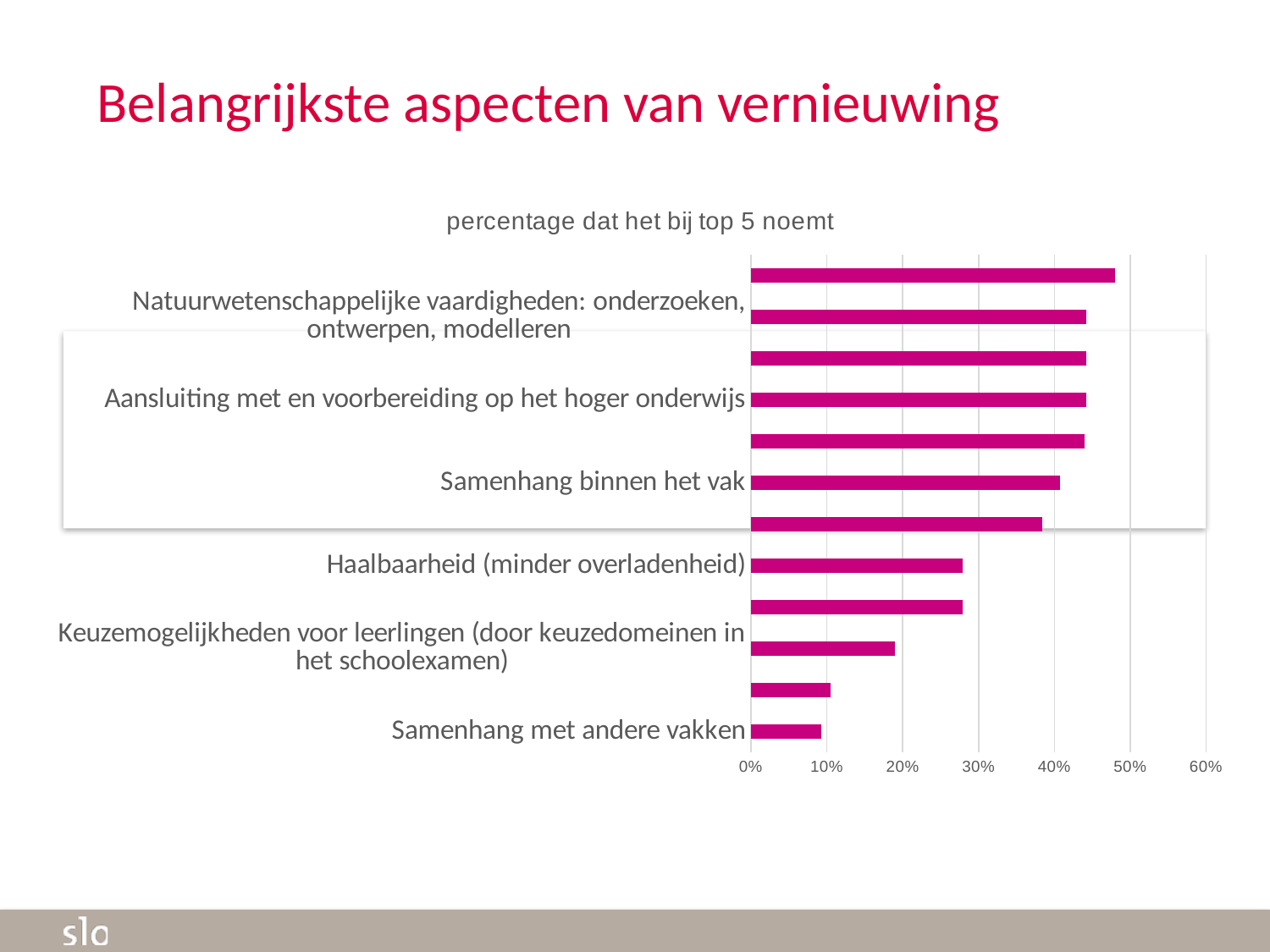
Is the value for 'Natuurwetenschappelijke vaardigheden: onderzoeken, ontwerpen, modelleren' greater or less than 50%? less Is the value for 'Samenhang binnen het vak' greater or less than 30%? greater What kind of chart is shown on the slide? bar chart Is the value for 'Keuzemogelijkheden voor leerlingen (door keuzedomeinen in het schoolexamen)' greater or less than 10%? greater How many bars are plotted in the chart? 12 What is the title of the chart? percentage dat het bij top 5 noemt Which has the larger value: 'Haalbaarheid (minder overladenheid)' or 'Samenhang met andere vakken'? Haalbaarheid (minder overladenheid) Which of the labelled categories has the lowest value? Samenhang met andere vakken What is the highest value shown on the horizontal axis? 60%